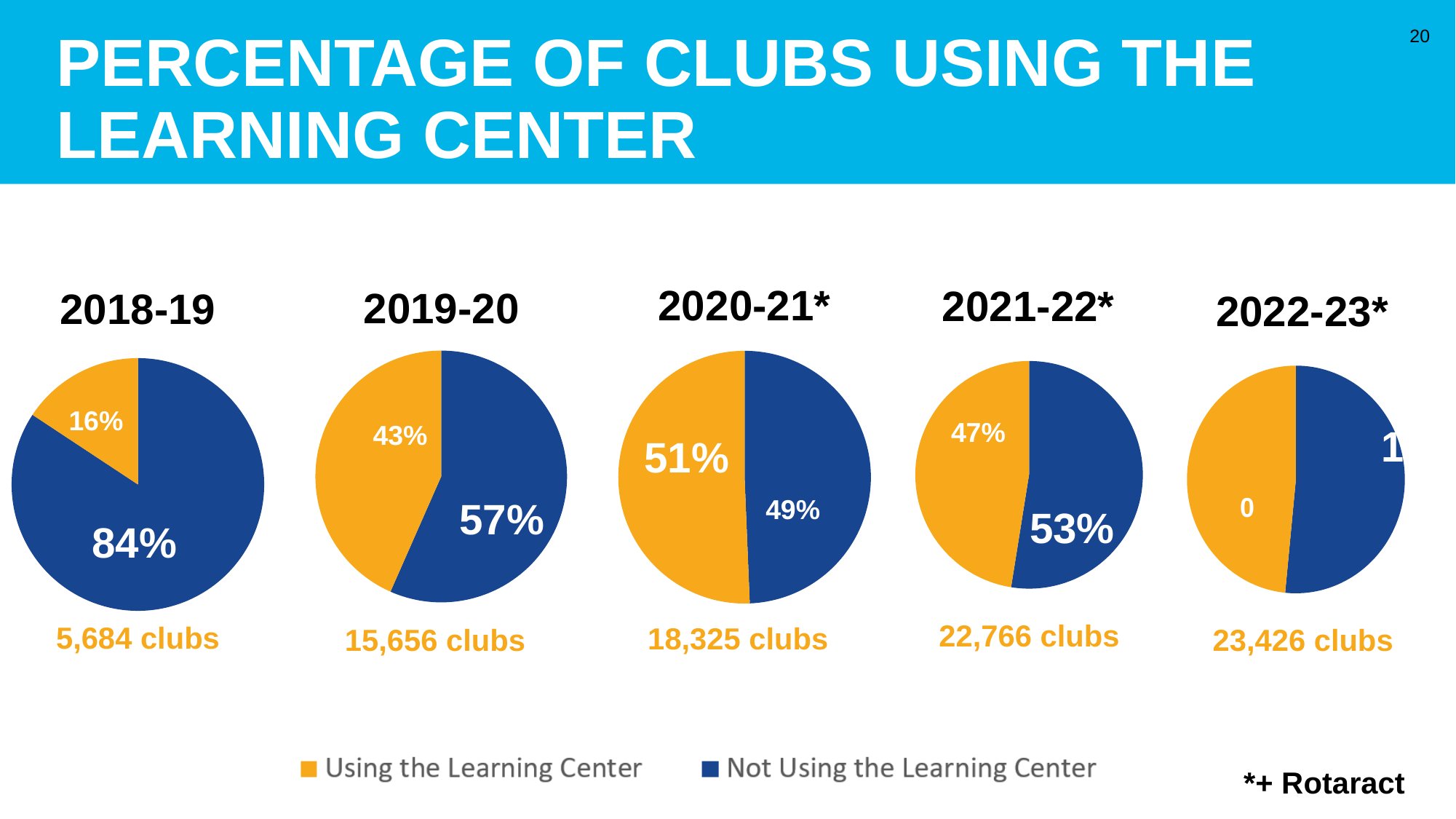
How many clubs are reported under the 2022-23* pie chart? 23,426 clubs In the 2018-19 pie chart, what percentage of clubs were not using the Learning Center? 84% How many series does the legend list? 2 In the 2018-19 pie chart, which slice is larger: Using the Learning Center or Not Using the Learning Center? Not Using the Learning Center In the 2020-21* pie chart, which slice is larger: Using the Learning Center or Not Using the Learning Center? Using the Learning Center In the 2018-19 pie chart, what percentage of clubs were using the Learning Center? 16% What kind of chart is used for the 2021-22* data? Pie chart How many pie charts are shown on the slide? 5 In the 2020-21* pie chart, what percentage of clubs were not using the Learning Center? 49% In the 2019-20 pie chart, what is the difference between the share not using and the share using the Learning Center? 14% In the 2021-22* pie chart, what percentage of clubs were using the Learning Center? 47% In the 2019-20 pie chart, what percentage of clubs were using the Learning Center? 43%